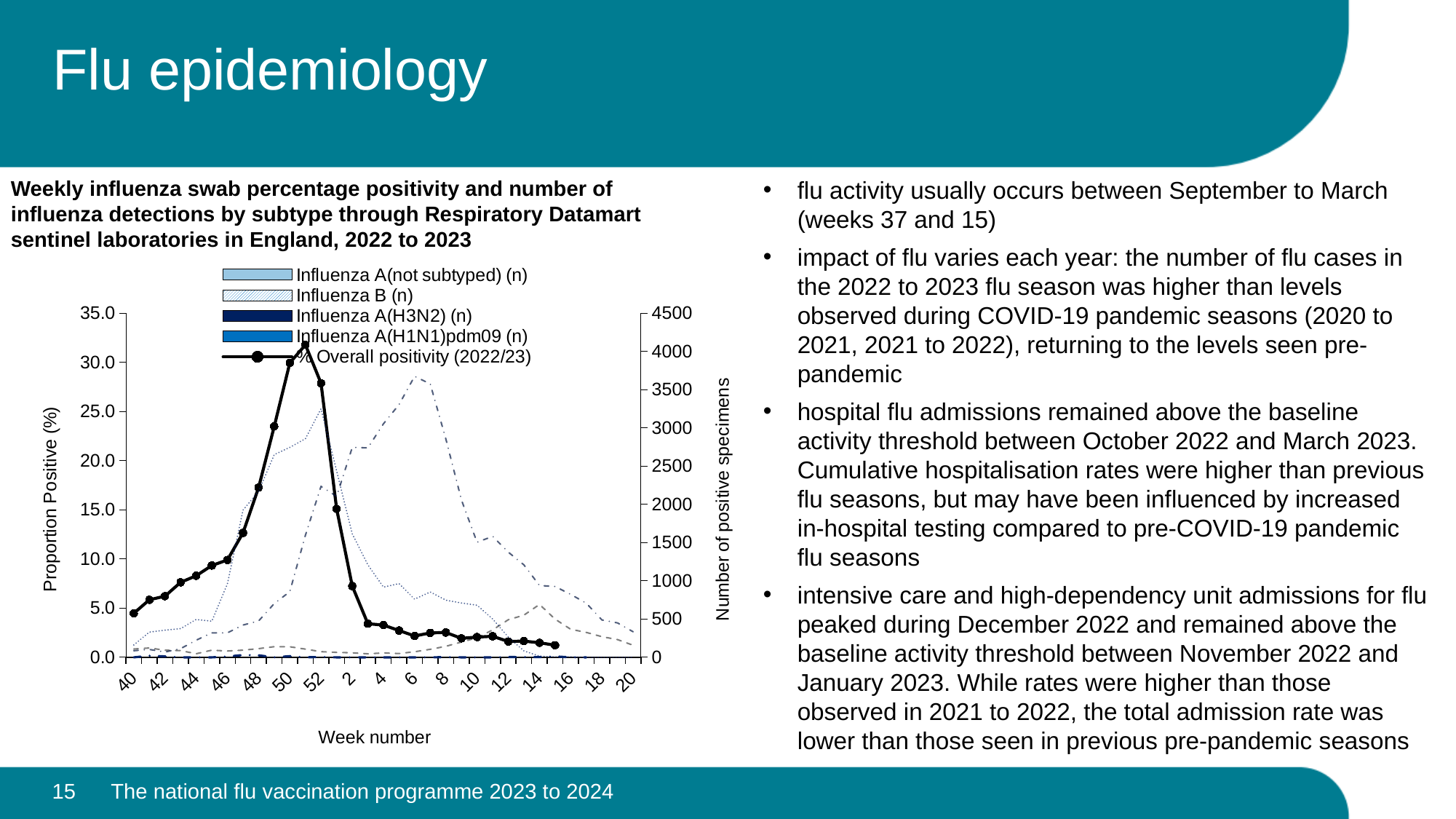
Which is larger, the % Overall positivity (2022/23) at week 42 or at week 4? week 42 Does the % Overall positivity (2022/23) line rise or fall between week 40 and week 50? rise Which is larger, the % Overall positivity (2022/23) at week 48 or at week 2? week 48 How many series does the chart legend list? 5 Is the % Overall positivity (2022/23) value at week 2 greater or less than 10.0? less Is the % Overall positivity (2022/23) value at week 50 greater or less than 25.0? greater What is the label of the left vertical axis? Proportion Positive (%) Is the % Overall positivity (2022/23) value at week 44 greater or less than 5.0? greater What is the label of the right vertical axis? Number of positive specimens Does the % Overall positivity (2022/23) line rise or fall between week 52 and week 4? fall